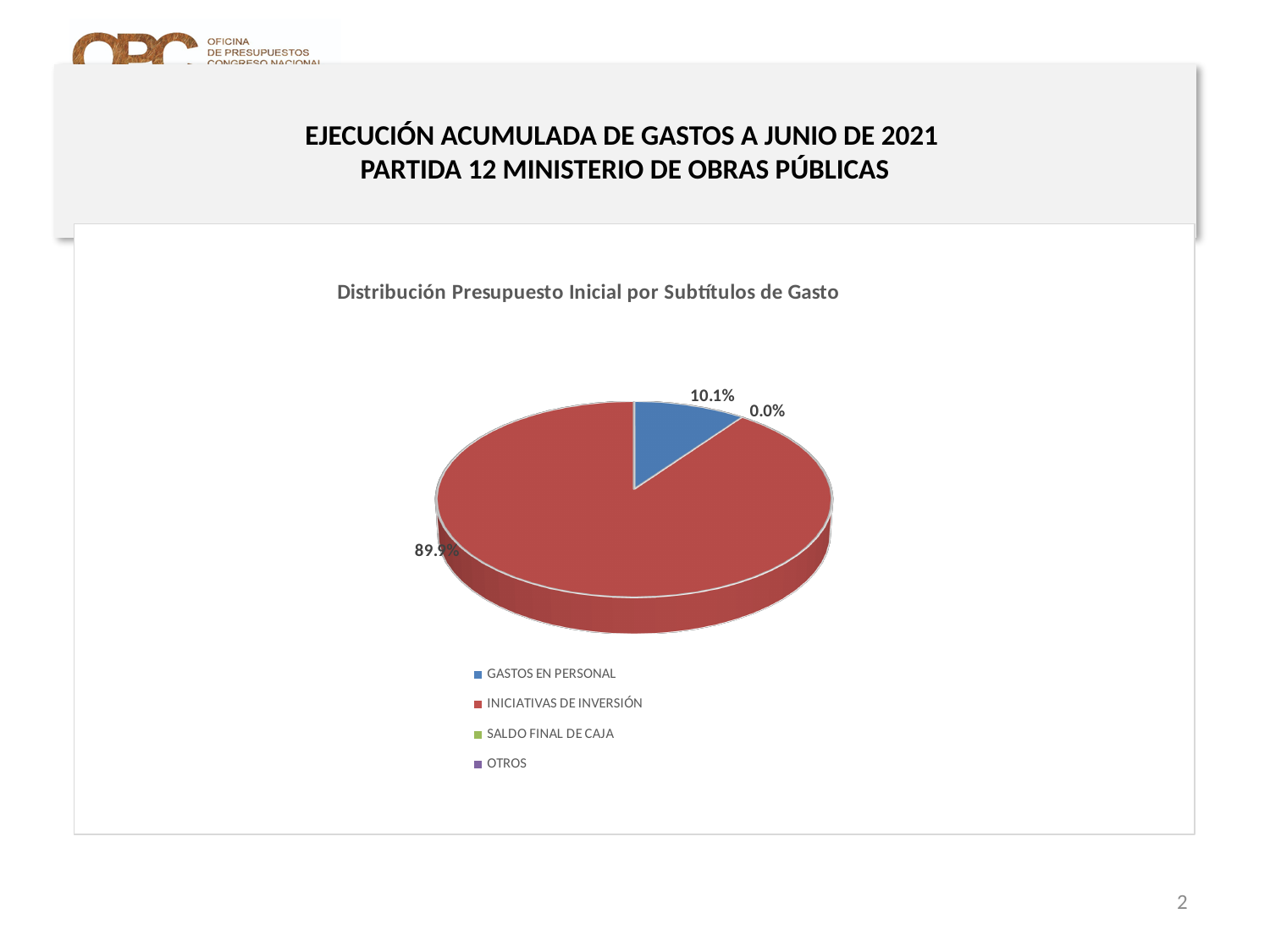
What share of the pie does GASTOS EN PERSONAL represent? 10.1% What kind of chart is shown on the slide? pie chart Is the share for INICIATIVAS DE INVERSIÓN greater or less than 50%? greater What is the title of the chart? Distribución Presupuesto Inicial por Subtítulos de Gasto Which is larger, the slice for GASTOS EN PERSONAL or the slice for INICIATIVAS DE INVERSIÓN? INICIATIVAS DE INVERSIÓN What colour is the slice for INICIATIVAS DE INVERSIÓN? red By how many percentage points does INICIATIVAS DE INVERSIÓN exceed GASTOS EN PERSONAL? 79.8 percentage points What share of the pie does INICIATIVAS DE INVERSIÓN represent? 89.9% What is the combined share of GASTOS EN PERSONAL and INICIATIVAS DE INVERSIÓN? 100.0% What is the smallest percentage value labelled on the pie? 0.0% Which category has the largest slice of the pie? INICIATIVAS DE INVERSIÓN How many categories does the legend list? 4